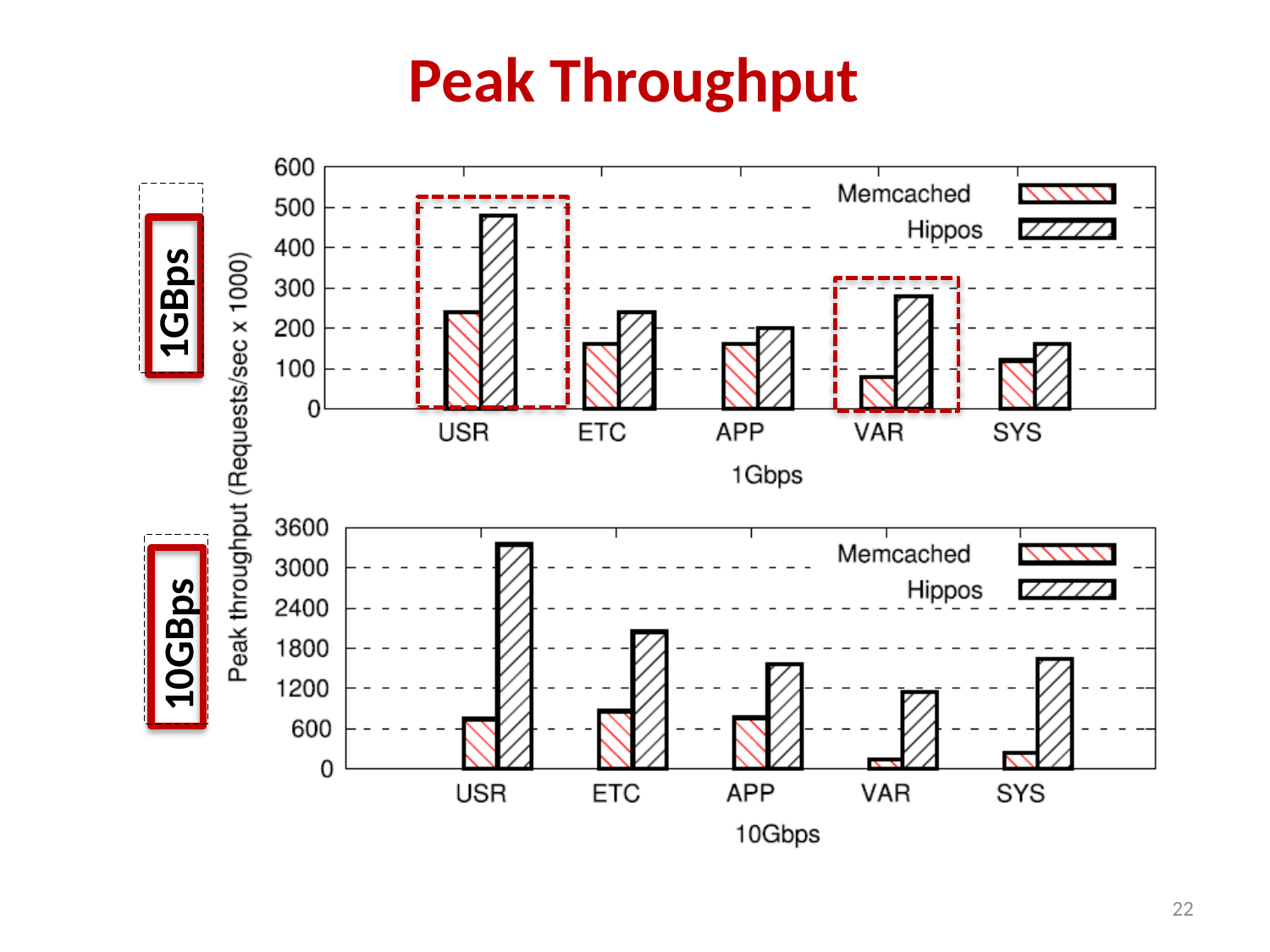
In the 1Gbps chart, is the Memcached value for VAR greater or less than 100? less In the 1Gbps chart, what kind of chart is shown? bar chart In the 1Gbps chart, which workload has the highest Hippos peak throughput? USR In the 10Gbps chart, how many workload categories are shown on the x axis? 5 In the 1Gbps chart, is the Hippos value for USR greater or less than 400? greater In the 10Gbps chart, is the Hippos value for USR greater or less than 3000? greater In the 10Gbps chart, which workload has the highest Hippos peak throughput? USR In the 10Gbps chart, which workload has the lowest Memcached peak throughput? VAR In the 10Gbps chart, what are the two series named in the legend? Memcached and Hippos In the 1Gbps chart, how many series does the legend list? 2 In the 1Gbps chart, for ETC, which is larger: Memcached or Hippos? Hippos In the 1Gbps chart, which workload has the lowest Memcached peak throughput? VAR